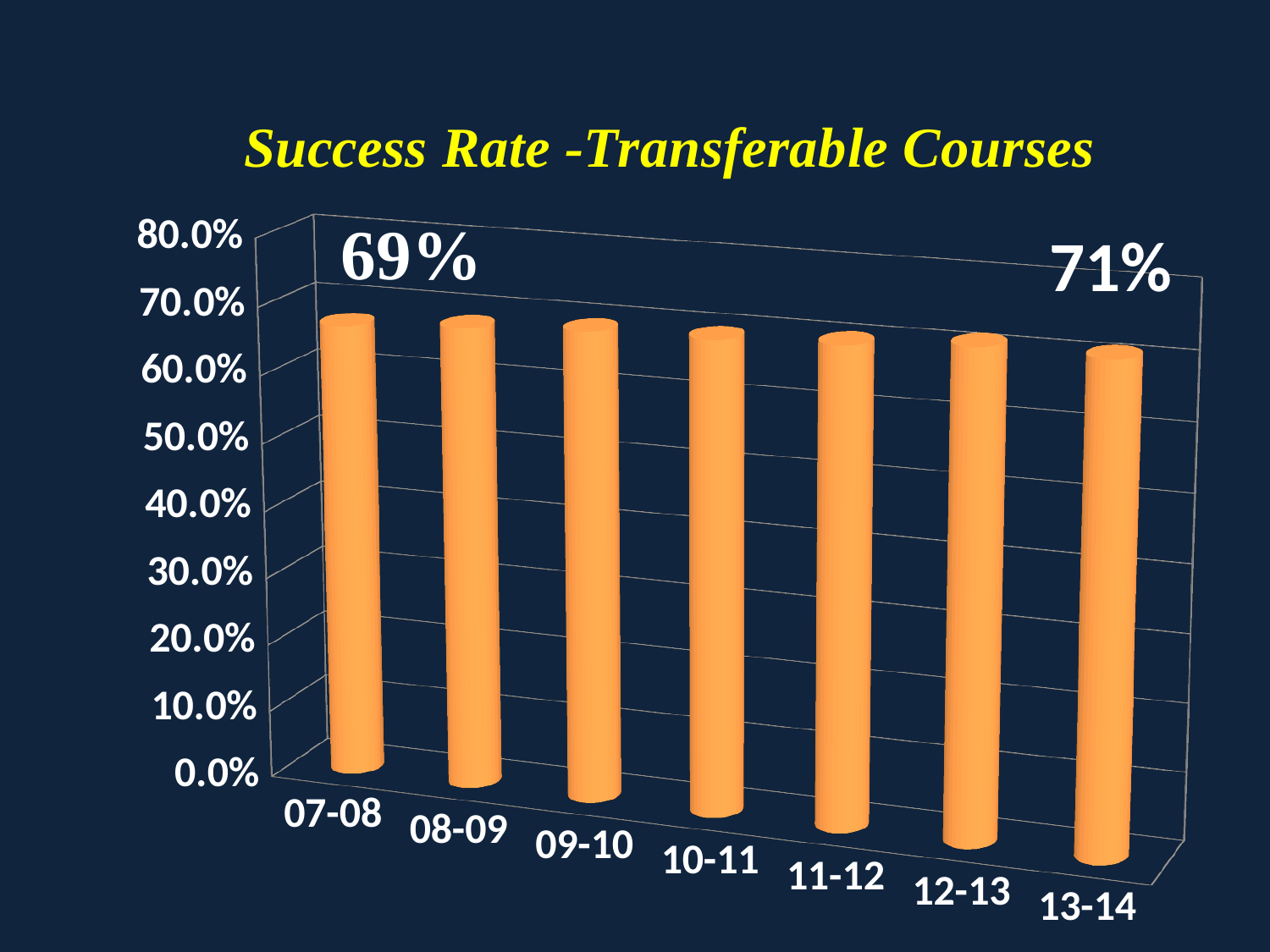
What type of chart is shown on the slide? bar chart What colour are the bars in the chart? orange What success rate is labelled for 13-14? 71% What is the title of the chart? Success Rate -Transferable Courses What is the difference between the labelled success rates for 13-14 and 07-08? 2 percentage points Is the value for 11-12 greater or less than 80.0%? less Which has the higher labelled success rate, 07-08 or 13-14? 13-14 How many academic years (categories) are plotted on the chart? 7 What success rate is labelled for 07-08? 69% What is the first category on the x axis? 07-08 Is the value for 09-10 greater or less than 40.0%? greater Is the value for 10-11 greater or less than 50.0%? greater